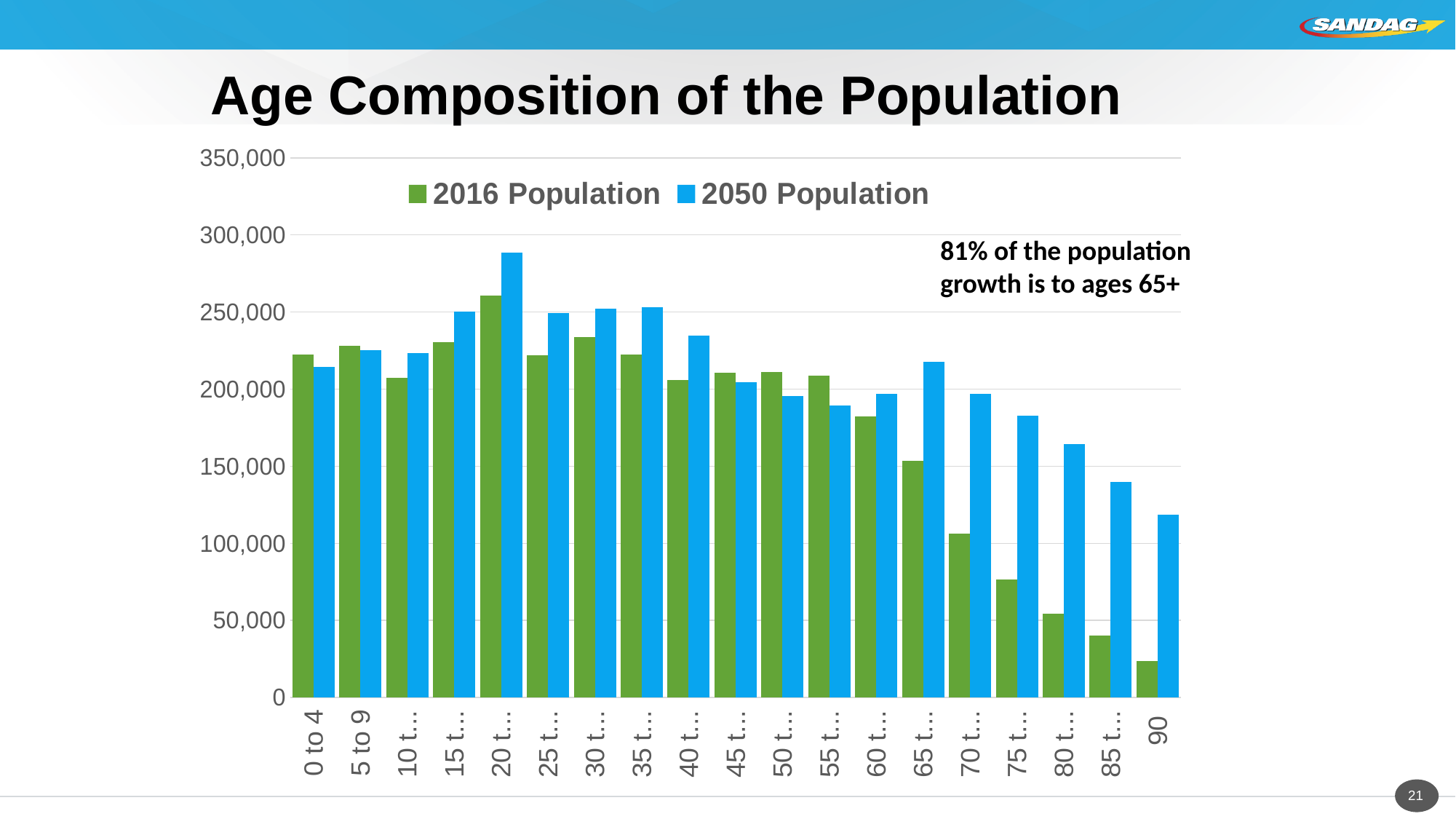
Is the 2050 Population value for the age group labelled '65 t...' greater or less than 200,000? greater Which age category has the highest 2050 Population value? 20 t... (the 20 age group) Which age category has the lowest 2050 Population value? 90 Is the 2050 Population value for the age group labelled '20 t...' greater or less than 250,000? greater What kind of chart is shown on the slide? Bar chart Is the 2016 Population value for the 90 age category greater or less than 50,000? less What are the two series named in the legend? 2016 Population and 2050 Population How many series does the legend list? 2 Do the 2016 Population values rise or fall across the age categories from '65 t...' to 90? fall Which age category has the lowest 2016 Population value? 90 For the age group labelled '40 t...', which is larger: the 2016 Population or the 2050 Population? 2050 Population How many age categories are shown on the x axis? 19